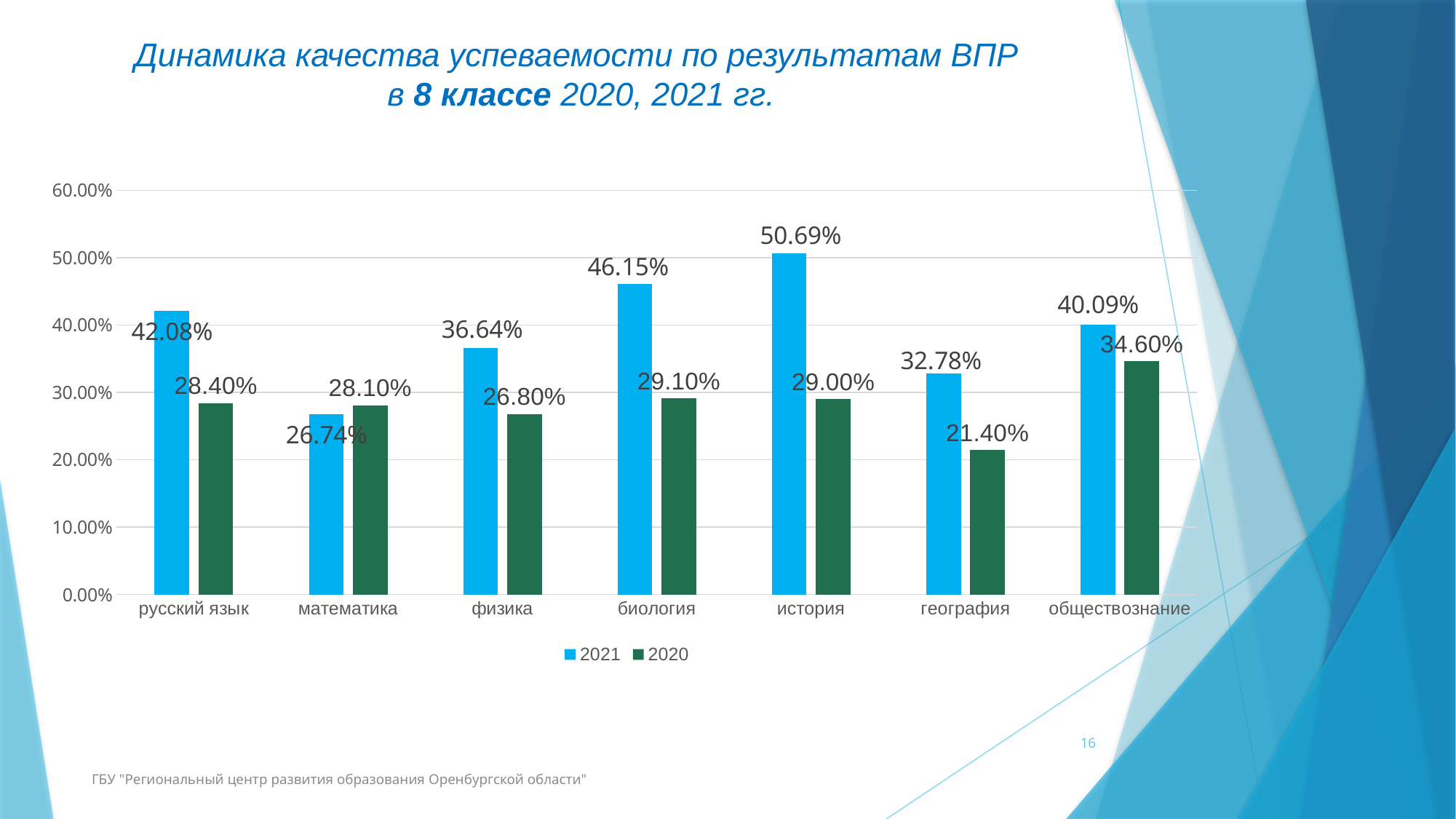
How many series does the legend list? 2 Which subject has the lowest 2021 value? математика Which is larger for математика, the 2021 value or the 2020 value? 2020 Which subject has the highest 2021 value? история Which colour represents the 2020 series in the legend? dark green What kind of chart is shown on the slide? bar chart What is the 2021 value for история? 50.69% How many subjects are shown on the x axis? 7 What is the difference between the 2021 and 2020 values for русский язык? 13.68% What is the 2021 value for физика? 36.64% Which subject has the lowest 2020 value? география What is the 2020 value for география? 21.40%